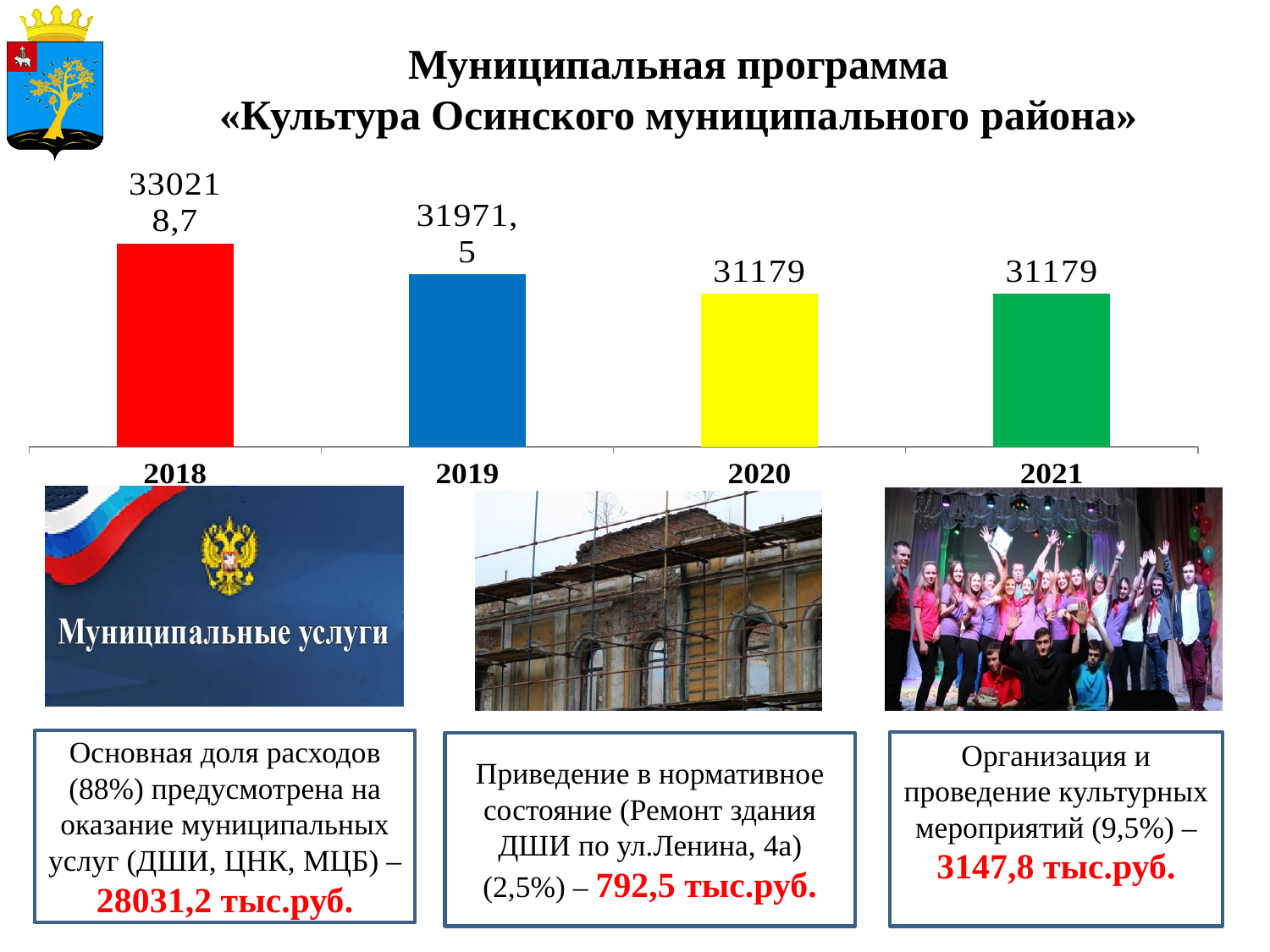
Do the values rise or fall from 2018 to 2020? Fall What colour is the bar for 2020? Yellow What kind of chart is shown on the slide? Bar chart Which is larger, the value for 2019 or the value for 2020? 2019 What is the value for 2021? 31179 Which year has the highest bar? 2018 What is the value for 2020? 31179 How many years are shown on the chart? 4 What is the value for 2019? 31971,5 What is the difference between the values for 2019 and 2020? 792,5 What colour is the bar for 2018? Red Are the values for 2020 and 2021 equal? Yes